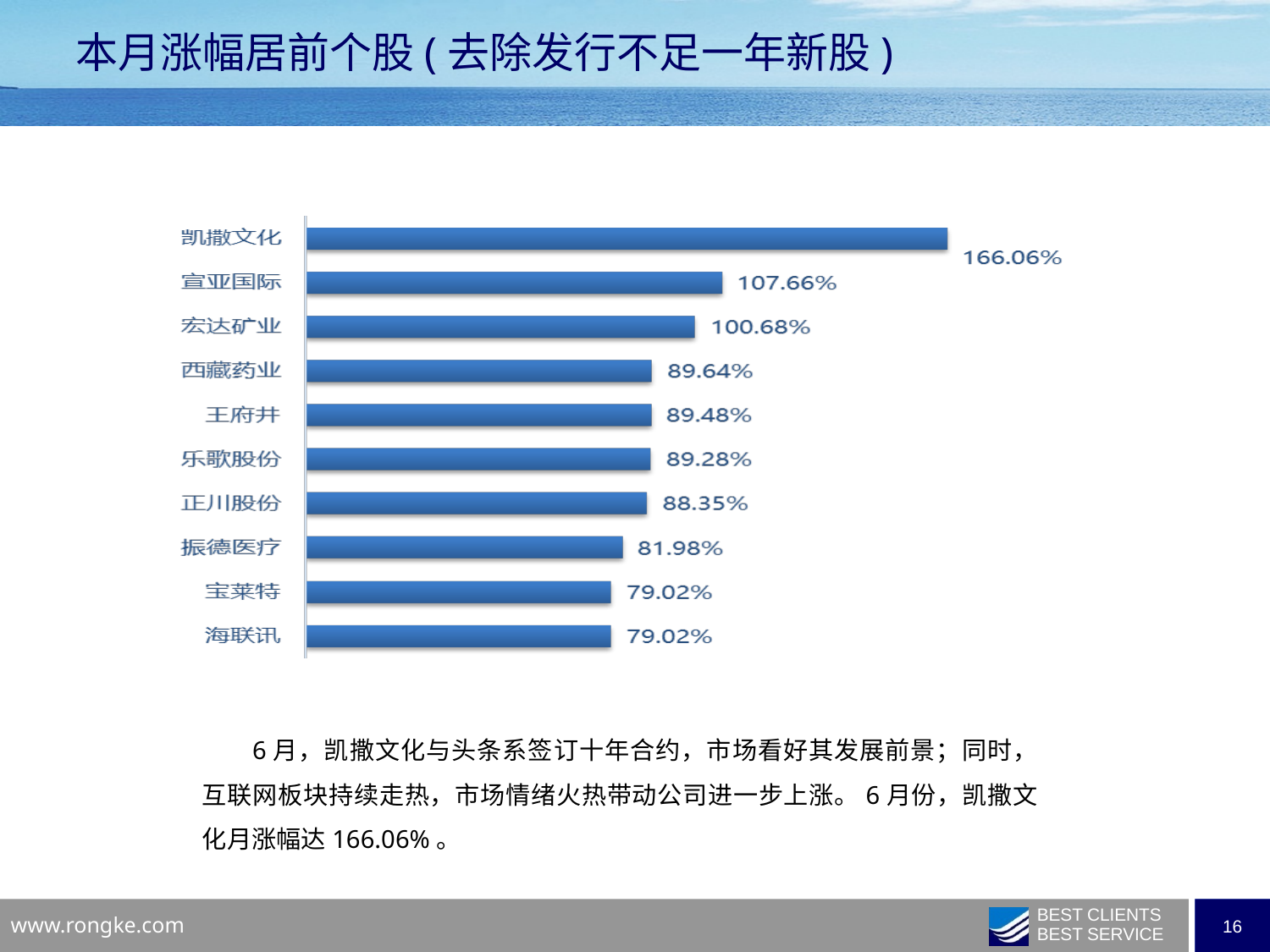
What is the difference between the values for 凯撒文化 and 宣亚国际? 58.40% What is the difference between the values for 宣亚国际 and 宏达矿业? 6.98% Which is larger, the value for 宏达矿业 or the value for 西藏药业? 宏达矿业 What kind of chart is shown on the slide? Bar chart What is the value shown for 振德医疗? 81.98% What is the value shown for 正川股份? 88.35% Which is larger, the value for 振德医疗 or the value for 宝莱特? 振德医疗 How many stocks are shown in the chart? 10 What is the value shown for 宏达矿业? 100.68% Which stock has the highest value in the chart? 凯撒文化 What is the value shown for 凯撒文化? 166.06% What is the title of the slide containing the chart? 本月涨幅居前个股(去除发行不足一年新股)